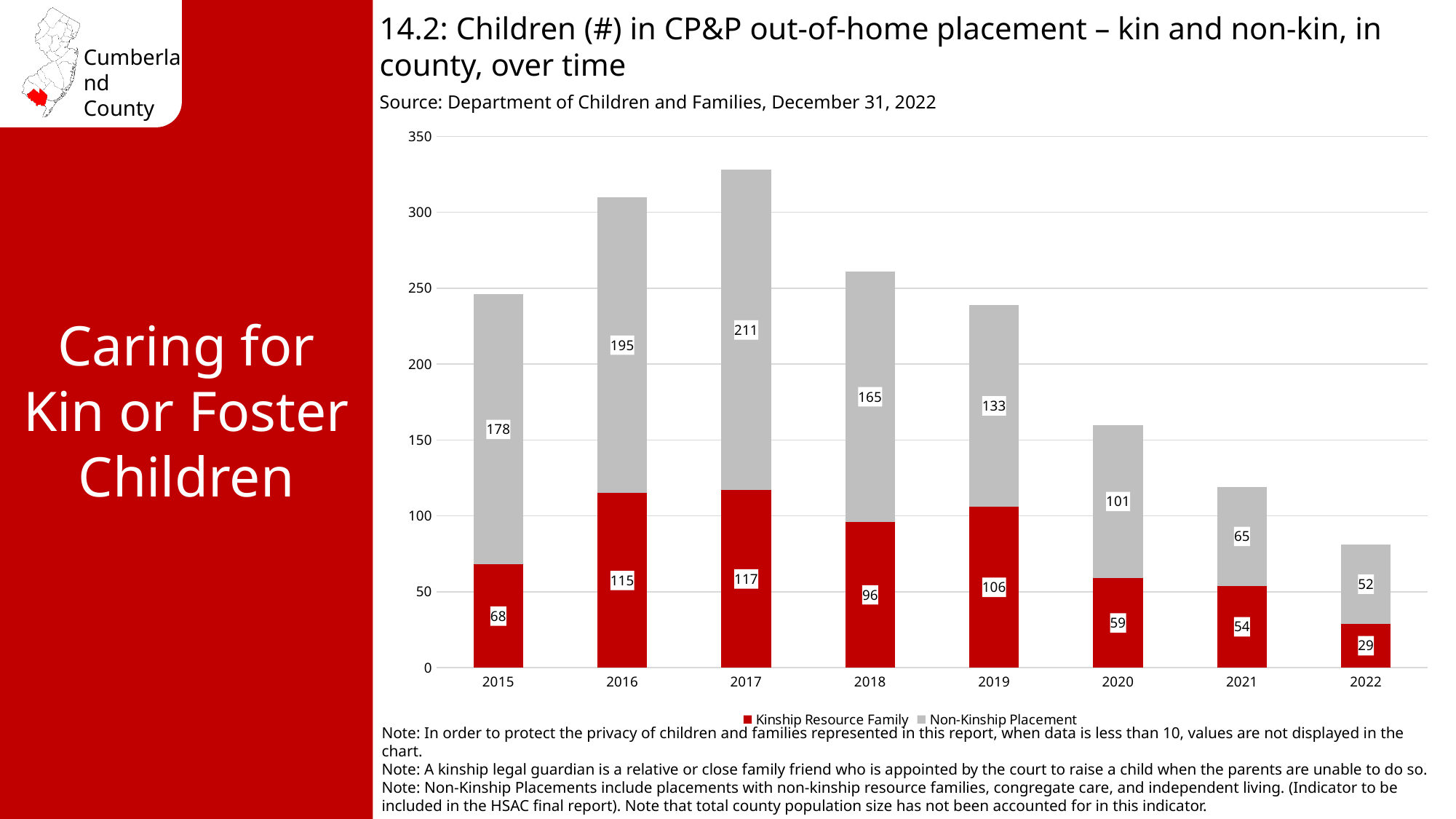
Which year has the highest Non-Kinship Placement value? 2017 What is the difference between the Non-Kinship Placement values for 2015 and 2020? 77 What type of chart is shown on the slide? Stacked bar chart How many series does the legend list? 2 What is the Kinship Resource Family value for 2022? 29 Which is larger: the Kinship Resource Family value for 2018 or for 2019? 2019 What is the Non-Kinship Placement value for 2019? 133 Which year has the lowest Kinship Resource Family value? 2022 How many years are shown on the x axis? 8 What is the overall trend of the total stacked bar heights from 2017 to 2022? Falling What is the Kinship Resource Family value for 2017? 117 What is the total number of children in out-of-home placement in 2016 (both series combined)? 310